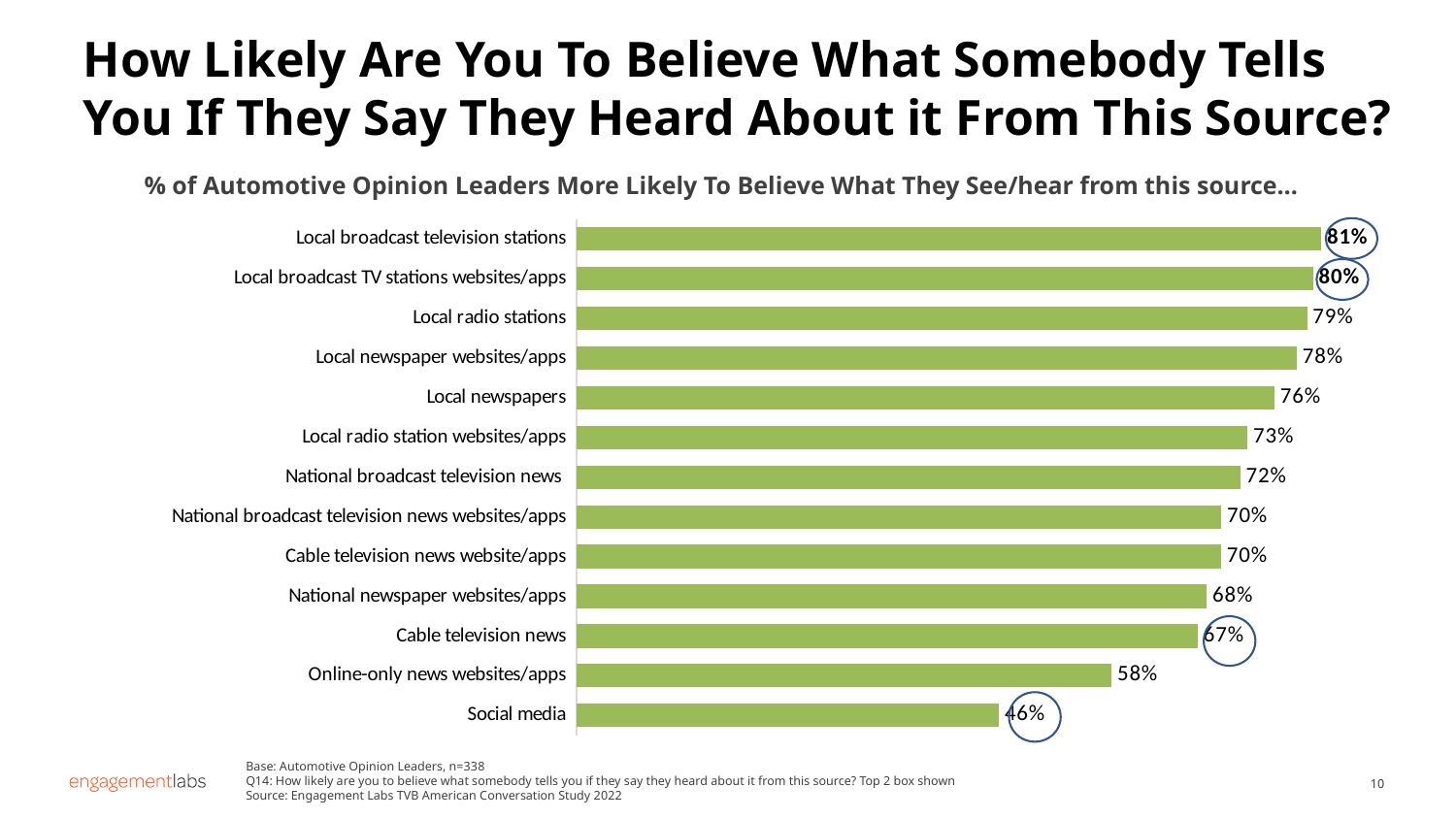
What is the value shown for Cable television news? 67% What kind of chart is shown on the slide? Bar chart What is the value shown for Social media? 46% What is the difference between the values for Local newspapers and Cable television news? 9 percentage points How many sources are shown in the chart? 13 What is the difference between the values for Local broadcast television stations and Social media? 35 percentage points What colour are the bars in the chart? Green Which source has the highest percentage? Local broadcast television stations What percentage of Automotive Opinion Leaders are more likely to believe what they hear from Local radio stations? 79% Which source has the lowest percentage? Social media What is the value shown for Online-only news websites/apps? 58% Which has a higher value, Local radio station websites/apps or National newspaper websites/apps? Local radio station websites/apps